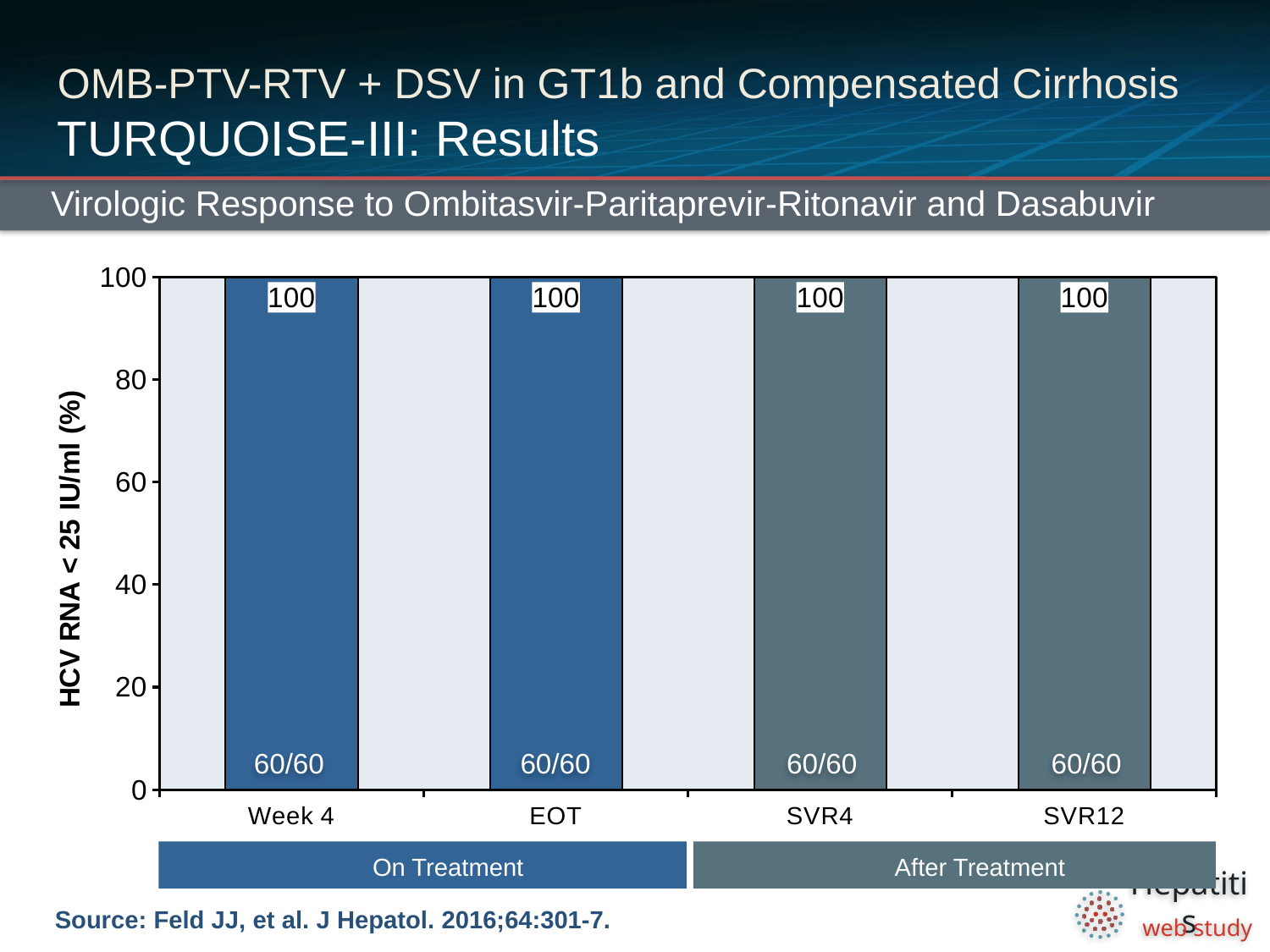
What fraction of patients is shown inside the SVR4 bar? 60/60 Which treatment phase group do the SVR4 and SVR12 bars belong to? After Treatment What kind of chart is shown on the slide? Bar chart What fraction of patients is shown inside the EOT bar? 60/60 What is the value for SVR12? 100 What is the label of the y axis? HCV RNA < 25 IU/ml (%) What is the value for Week 4? 100 Do the values rise, fall, or stay the same from Week 4 to SVR12? Stay the same What is the difference between the values for EOT and SVR12? 0 How many categories are shown on the x axis? 4 Is the value for SVR4 greater or less than 80? greater